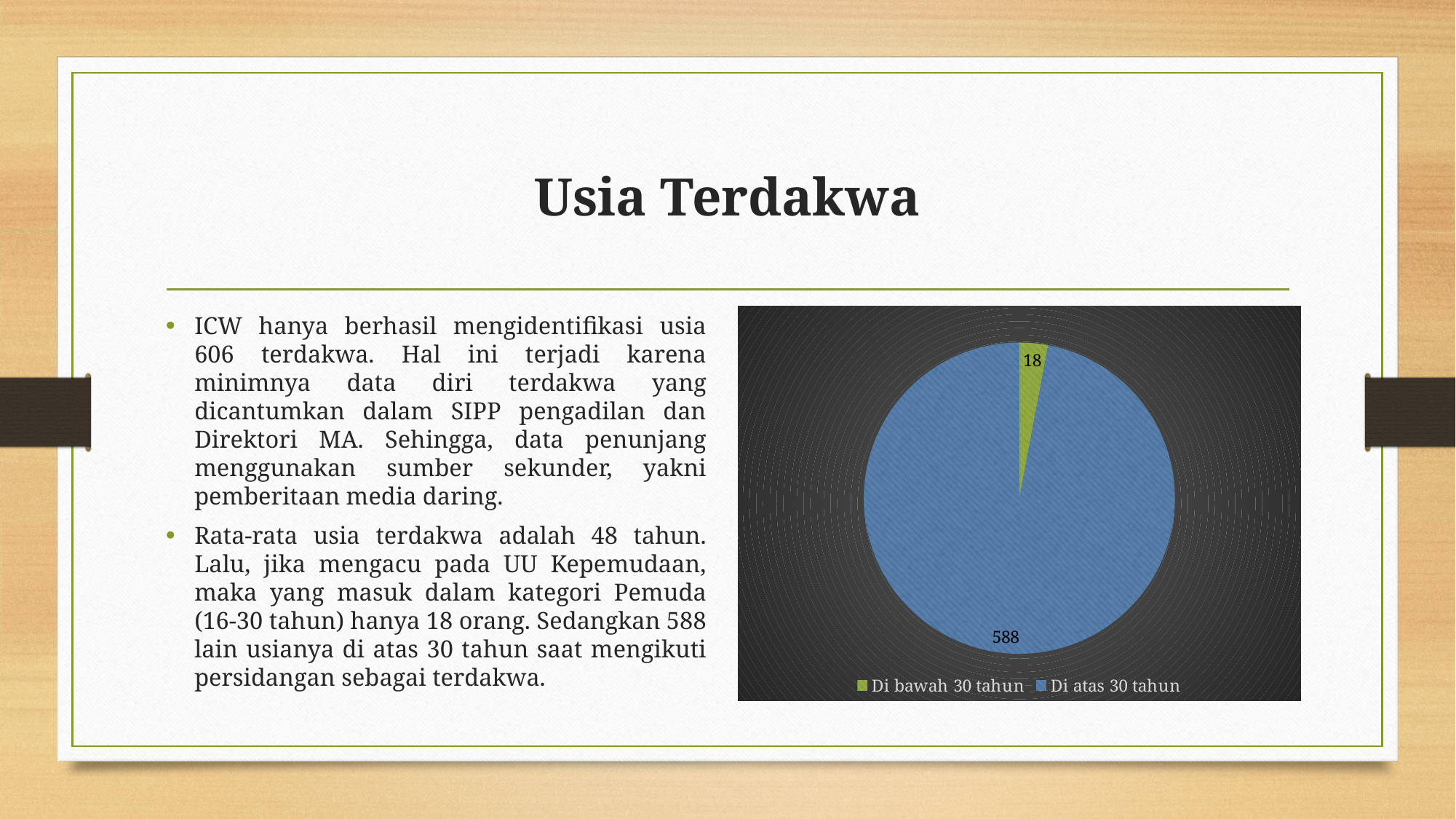
How many categories does the pie chart show? 2 How many entries does the legend of the pie chart list? 2 What is the total of the two values shown in the pie chart? 606 Which colour represents "Di atas 30 tahun" in the pie chart? blue Which category has the largest slice in the pie chart? Di atas 30 tahun Which category has the smallest slice in the pie chart? Di bawah 30 tahun What is the value for "Di atas 30 tahun" in the pie chart? 588 Which is larger: the value for "Di bawah 30 tahun" or "Di atas 30 tahun"? Di atas 30 tahun What kind of chart is shown on the slide? pie chart Which colour represents "Di bawah 30 tahun" in the pie chart? green What is the difference between the values for "Di atas 30 tahun" and "Di bawah 30 tahun"? 570 What is the value for "Di bawah 30 tahun" in the pie chart? 18